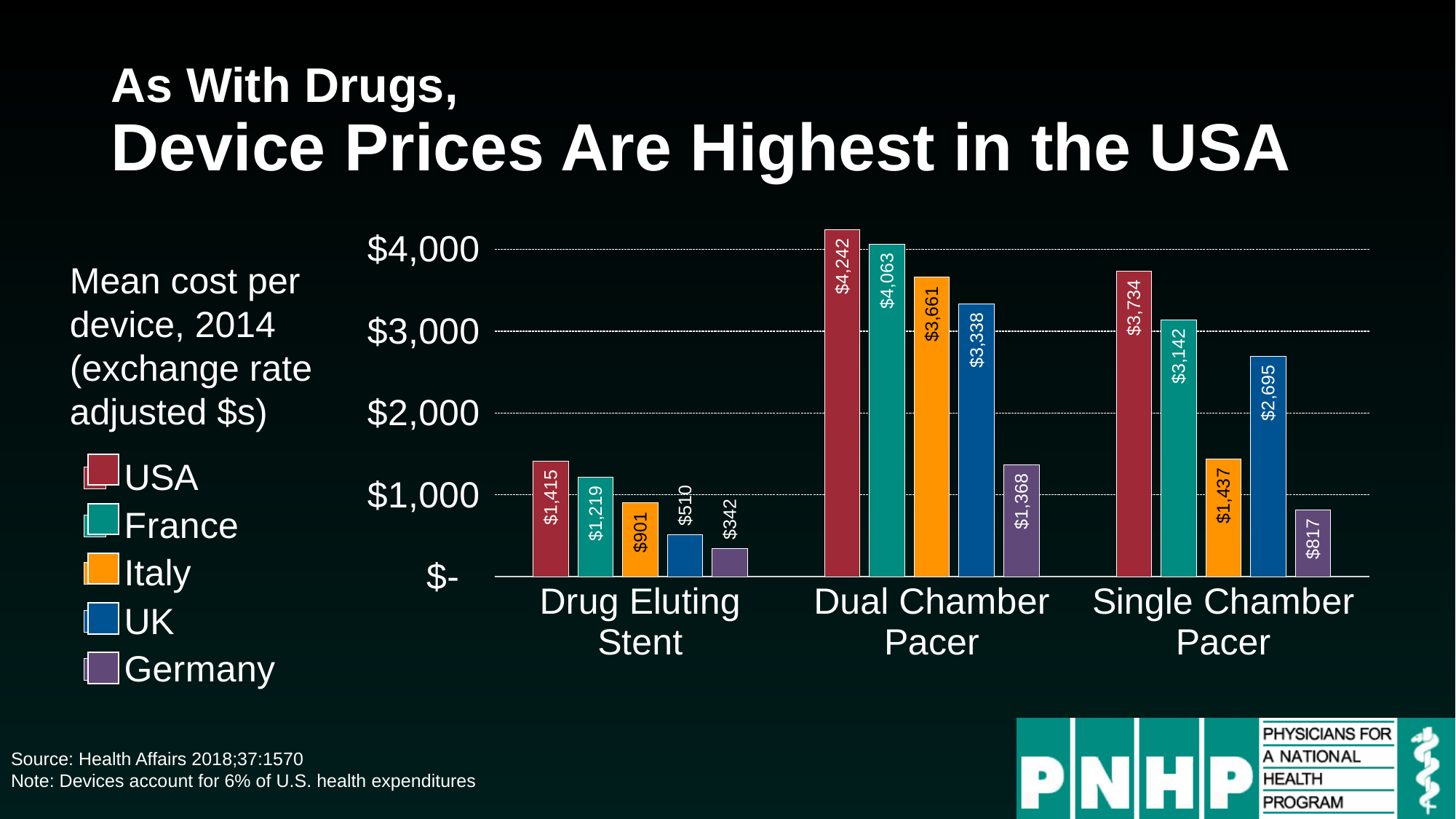
Which country has the highest mean cost for a Dual Chamber Pacer? USA What kind of chart is shown on the slide? Bar chart Is the France value for a Dual Chamber Pacer greater or less than $4,000? greater How many countries does the legend list? 5 What is the mean cost of a Dual Chamber Pacer in Germany? $1,368 Which is larger: the Italy cost for a Dual Chamber Pacer or the UK cost for a Dual Chamber Pacer? Italy What is the mean cost of a Single Chamber Pacer in the UK? $2,695 What is the mean cost of a Drug Eluting Stent in the USA? $1,415 Which colour represents Italy in the chart? Orange How many device categories are shown on the x axis? 3 What is the difference between the USA and France mean cost for a Single Chamber Pacer? $592 Which country has the lowest mean cost for a Drug Eluting Stent? Germany